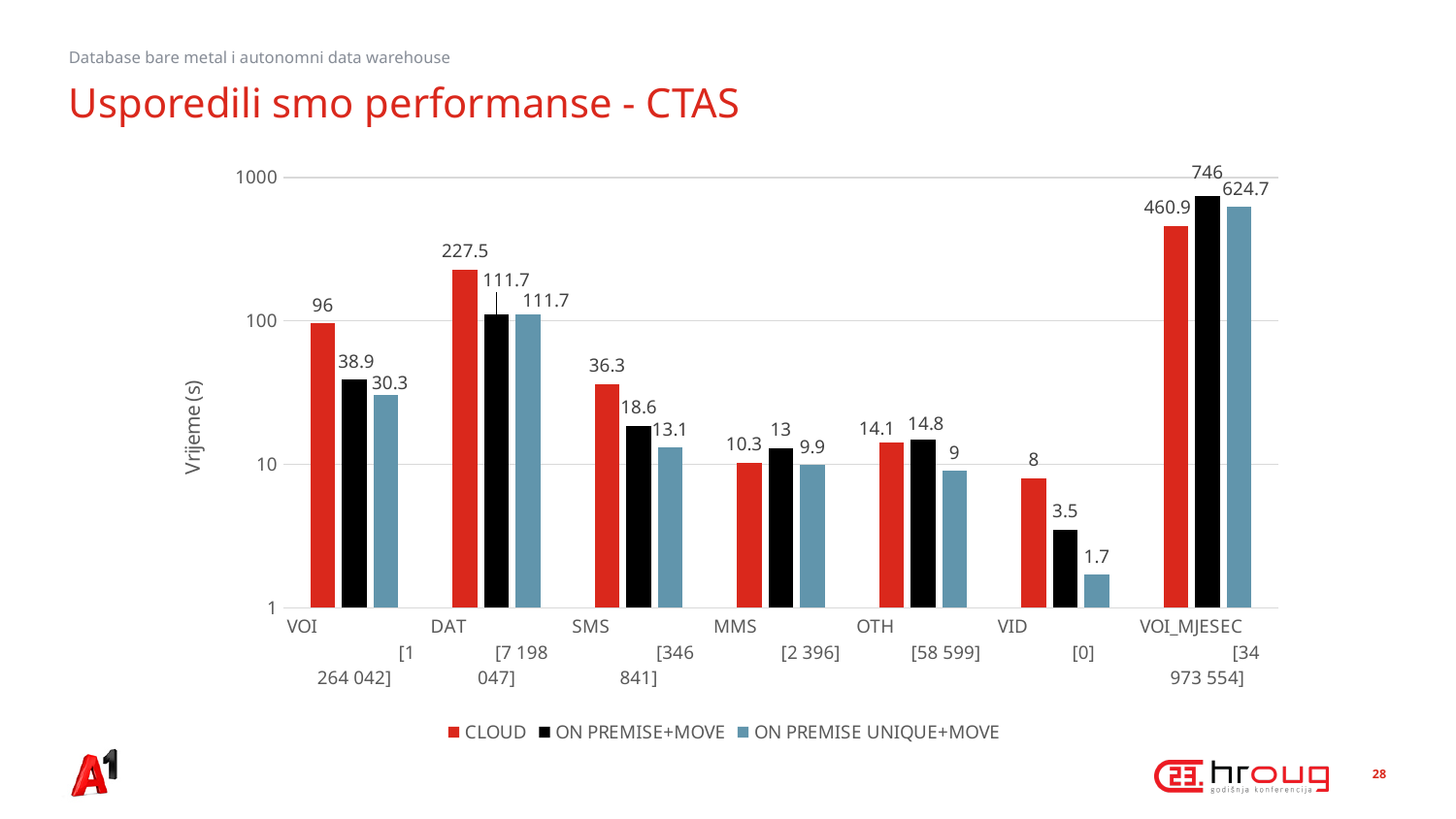
How many series does the legend list? 3 What is the ON PREMISE UNIQUE+MOVE value for VID? 1.7 What kind of chart is shown on the slide? bar chart For OTH, which is larger: the CLOUD value or the ON PREMISE+MOVE value? ON PREMISE+MOVE Is the CLOUD value for SMS greater or less than 100? less Which category has the lowest ON PREMISE UNIQUE+MOVE value? VID How many categories are shown on the x axis? 7 Which category has the highest CLOUD value? VOI_MJESEC What is the label of the y axis? Vrijeme (s) What is the difference between the CLOUD and ON PREMISE+MOVE values for VOI? 57.1 What is the ON PREMISE+MOVE value for VOI_MJESEC? 746 What is the CLOUD value for DAT? 227.5